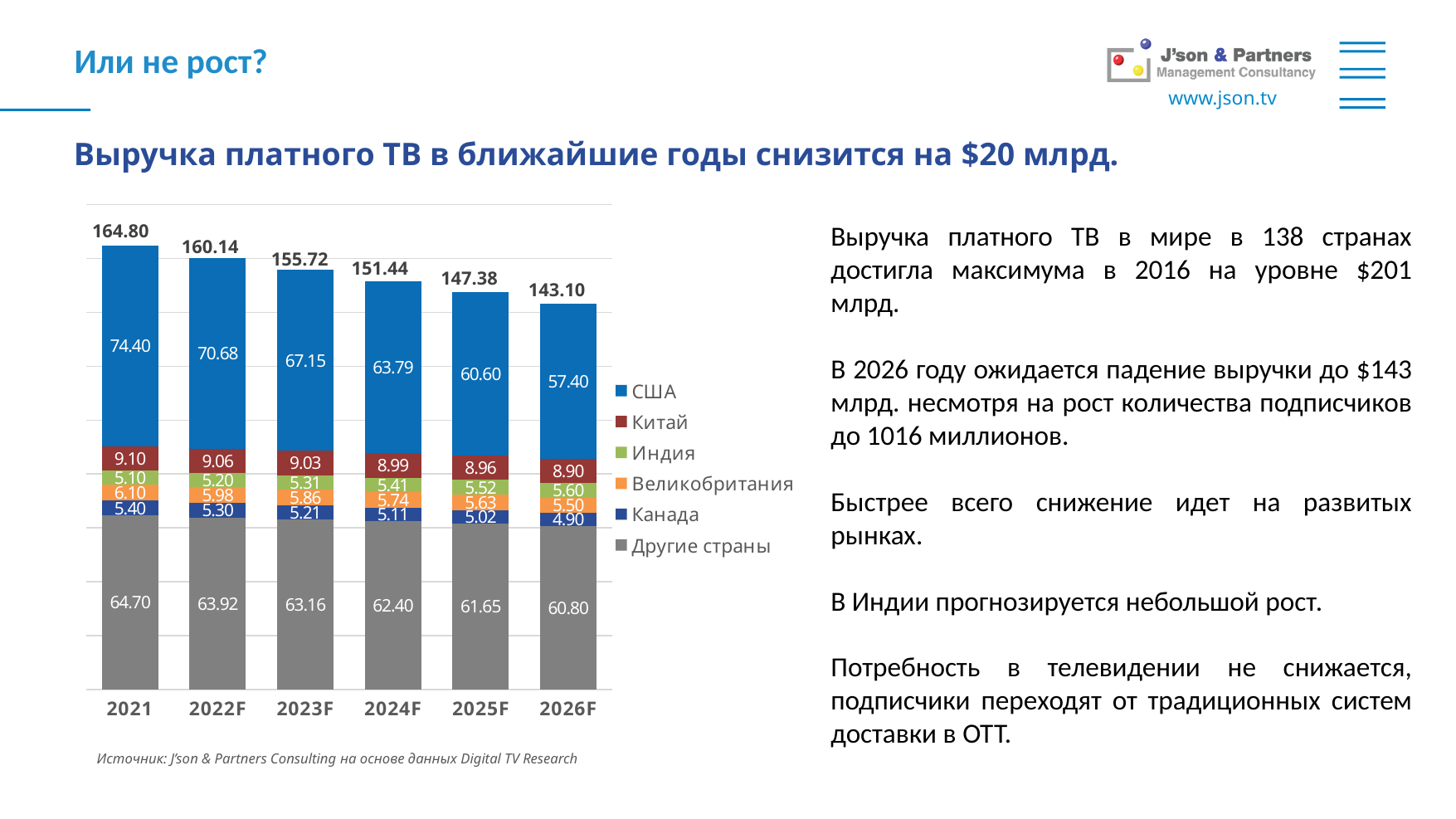
Which year has the lowest total? 2026F What is the value for Другие страны in 2026F? 60.80 What is the difference between the total for 2021 and the total for 2026F? 21.70 What is the total of the stacked bar for 2023F? 155.72 What kind of chart is shown on the slide? Stacked bar chart What is the value for США in 2021? 74.40 How many series does the legend list? 6 How many years are shown on the x axis? 6 What is the value for Индия in 2024F? 5.41 Which is larger in 2025F: the value for Китай or the value for Великобритания? Китай Which year has the highest total? 2021 Do the values for США rise or fall from 2021 to 2026F? Fall